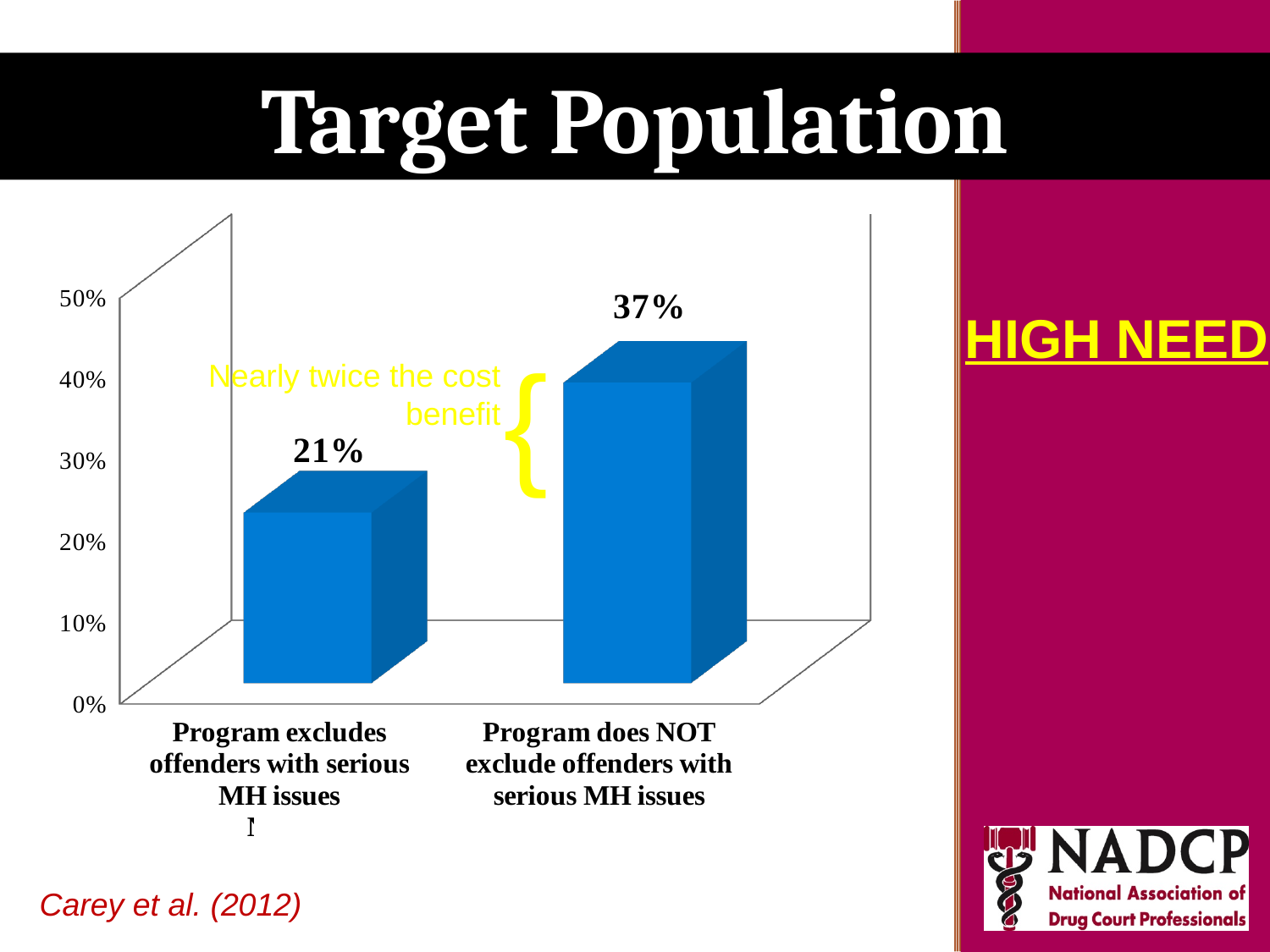
What is the value for "Program does NOT exclude offenders with serious MH issues"? 37% What is the highest value shown on the vertical axis of the chart? 50% Which category has the highest value? Program does NOT exclude offenders with serious MH issues What is the title of the slide containing the chart? Target Population Which category has the lowest value? Program excludes offenders with serious MH issues Which is larger: the value for "Program excludes offenders with serious MH issues" or the value for "Program does NOT exclude offenders with serious MH issues"? Program does NOT exclude offenders with serious MH issues How many categories are shown in the chart? 2 What is the difference between the values for "Program does NOT exclude offenders with serious MH issues" and "Program excludes offenders with serious MH issues"? 16% Is the value for "Program excludes offenders with serious MH issues" greater or less than 30%? less Is the value for "Program does NOT exclude offenders with serious MH issues" greater or less than 30%? greater What is the value for "Program excludes offenders with serious MH issues"? 21% What kind of chart is shown on the slide? bar chart